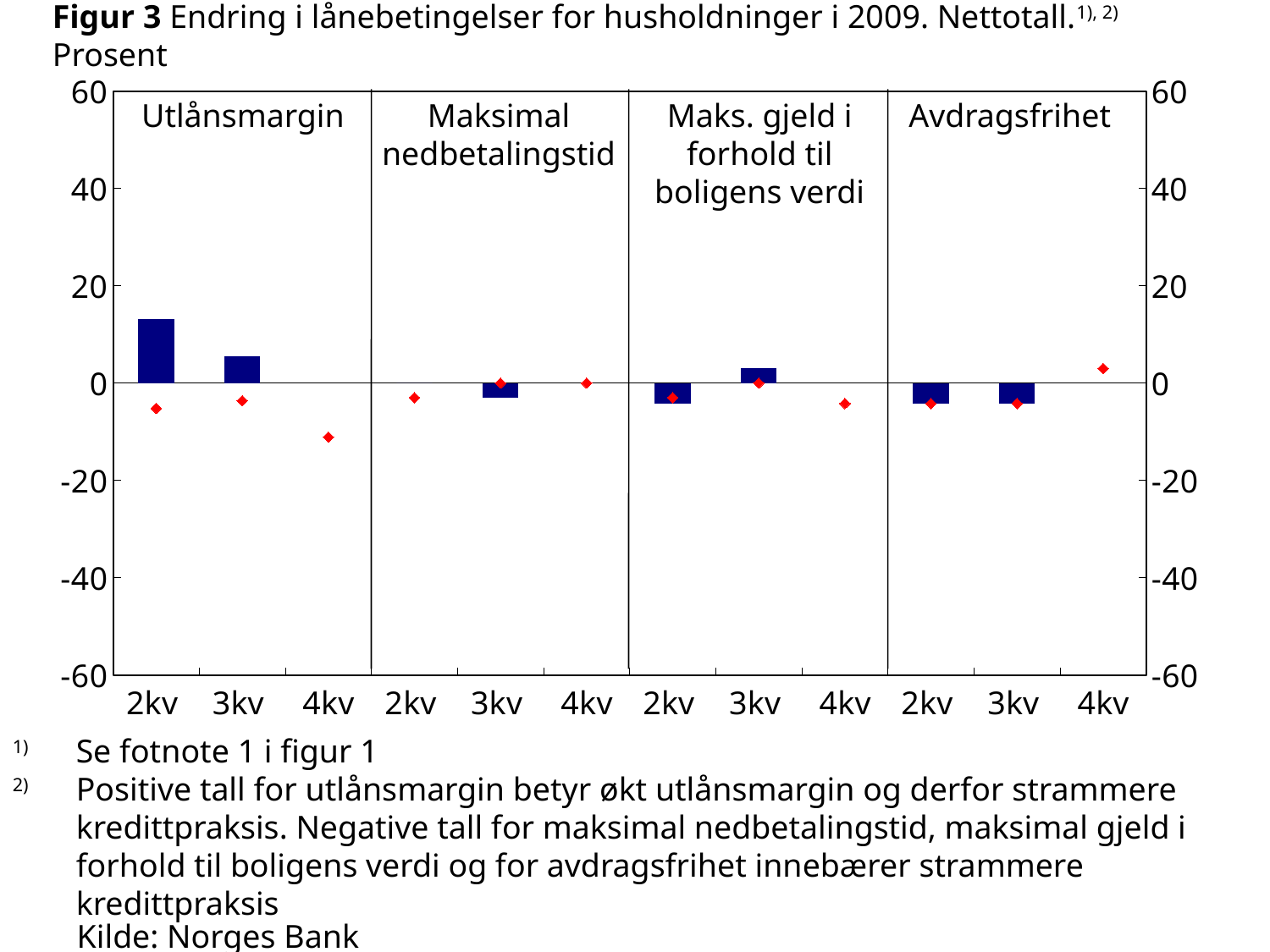
In the Utlånsmargin panel, which quarter has the lowest red marker? 4kv Is the red marker for 4kv in the Utlånsmargin panel greater or less than -20? greater What source is cited for the chart? Norges Bank In the Utlånsmargin panel, which bar is larger, 2kv or 3kv? 2kv Is the bar for 2kv in the Utlånsmargin panel greater or less than 0? greater How many lending-condition panels (categories) does the chart show? 4 Which panel and quarter has the tallest bar in the chart? Utlånsmargin, 2kv How many quarters are plotted within each panel of the chart? 3 Do the bars in the Utlånsmargin panel rise or fall from 2kv to 4kv? fall What kind of chart is shown in Figur 3? combination chart with bars and red diamond markers Is the bar for 3kv in the Maks. gjeld i forhold til boligens verdi panel greater or less than 0? greater